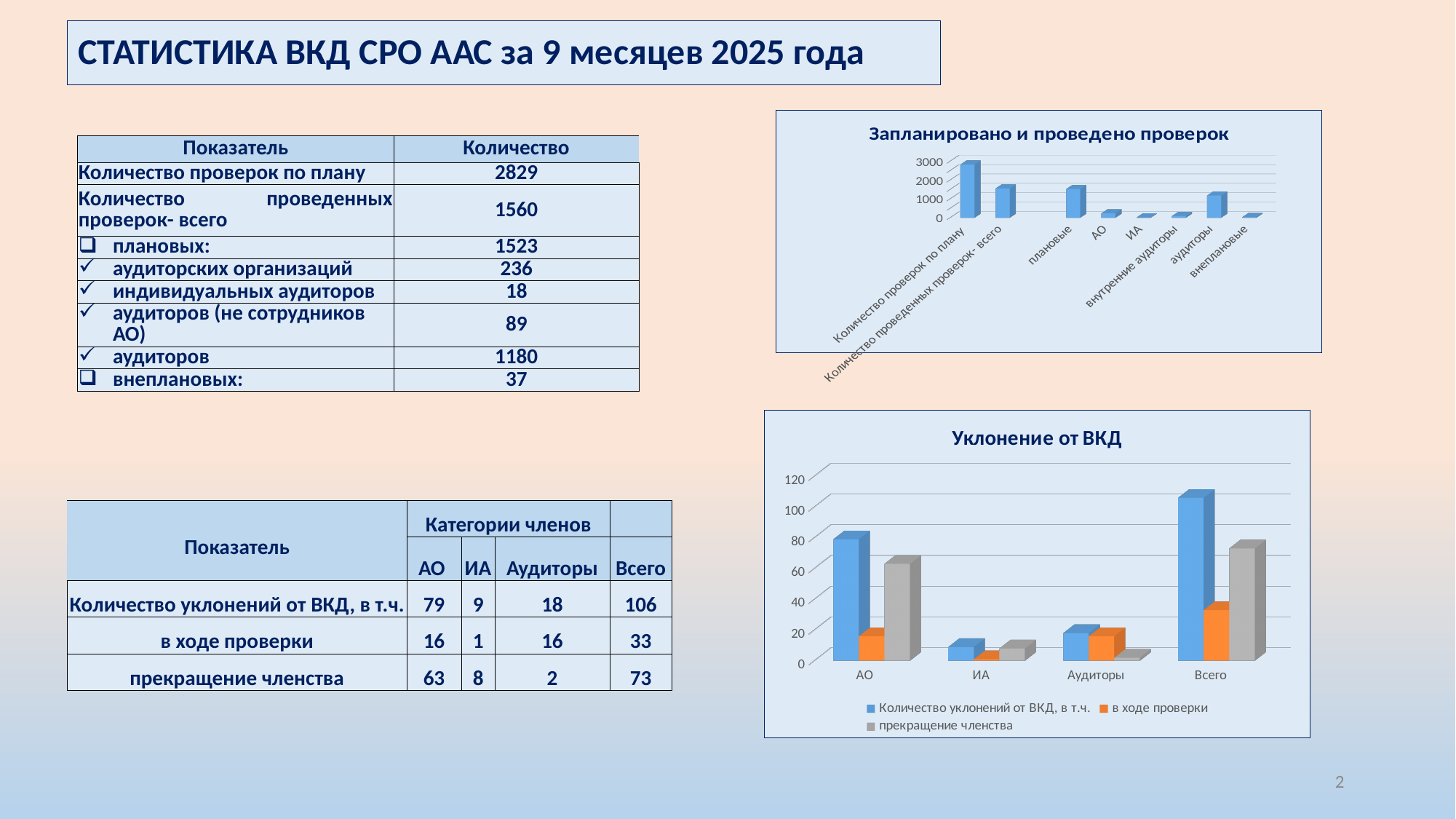
In the chart "Уклонение от ВКД", what is the value of "прекращение членства" for "АО"? 63 In the chart "Уклонение от ВКД", what colour represents the series "в ходе проверки" in the legend? orange What kind of chart is the chart titled "Запланировано и проведено проверок"? bar chart In the chart "Запланировано и проведено проверок", is the value for "плановые" greater or less than 1000? greater In the chart "Уклонение от ВКД", for the category "АО", which is larger: "в ходе проверки" or "прекращение членства"? прекращение членства In the chart "Запланировано и проведено проверок", which is larger: the bar for "аудиторы" or the bar for "АО"? аудиторы In the chart "Запланировано и проведено проверок", which category has the highest bar? Количество проверок по плану In the chart "Уклонение от ВКД", what is the value of "Количество уклонений от ВКД, в т.ч." for "Всего"? 106 In the chart "Запланировано и проведено проверок", is the value for "Количество проверок по плану" greater or less than 2000? greater How many series does the legend of the chart "Уклонение от ВКД" list? 3 In the chart "Запланировано и проведено проверок", how many categories are shown on the x axis? 8 In the chart "Уклонение от ВКД", how many categories are shown on the x axis? 4